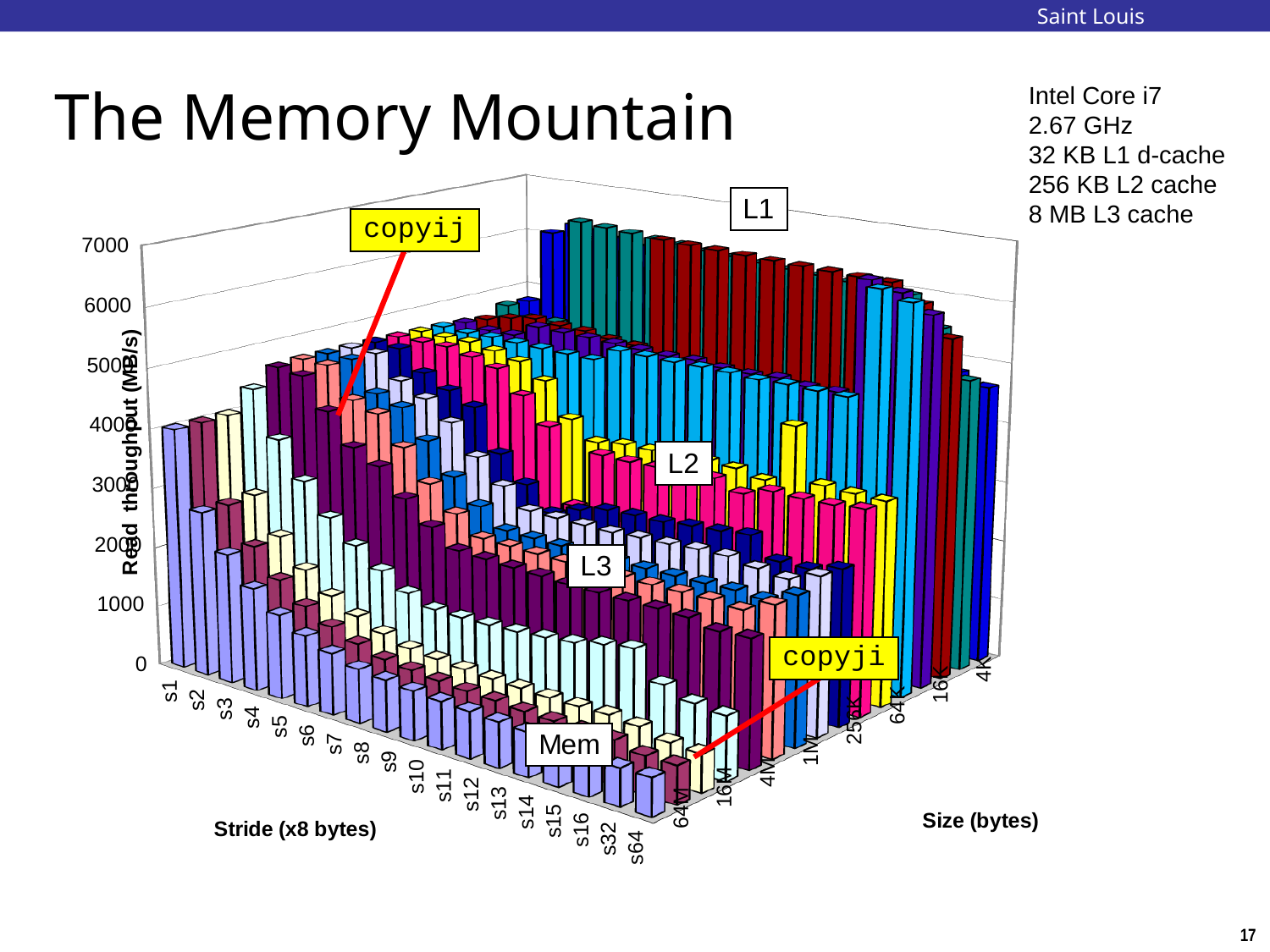
What kind of chart is shown on the slide? 3D bar chart What is the largest size category labelled on the Size (bytes) axis? 64M What is the highest tick value shown on the vertical axis? 7000 Is the read throughput for stride s64 at size 64M greater or less than 1000? less What is the smallest stride category labelled on the stride axis? s1 What is the label of the stride axis of the chart? Stride (x8 bytes) Which size, 4K or 64M, gives the higher read throughput at stride s1? 4K How many stride categories are labelled along the stride axis? 18 What is the label of the vertical axis of the chart? Read throughput (MB/s) For size 64M, does read throughput rise or fall as the stride increases from s1 to s64? fall How many size categories are labelled along the Size (bytes) axis? 8